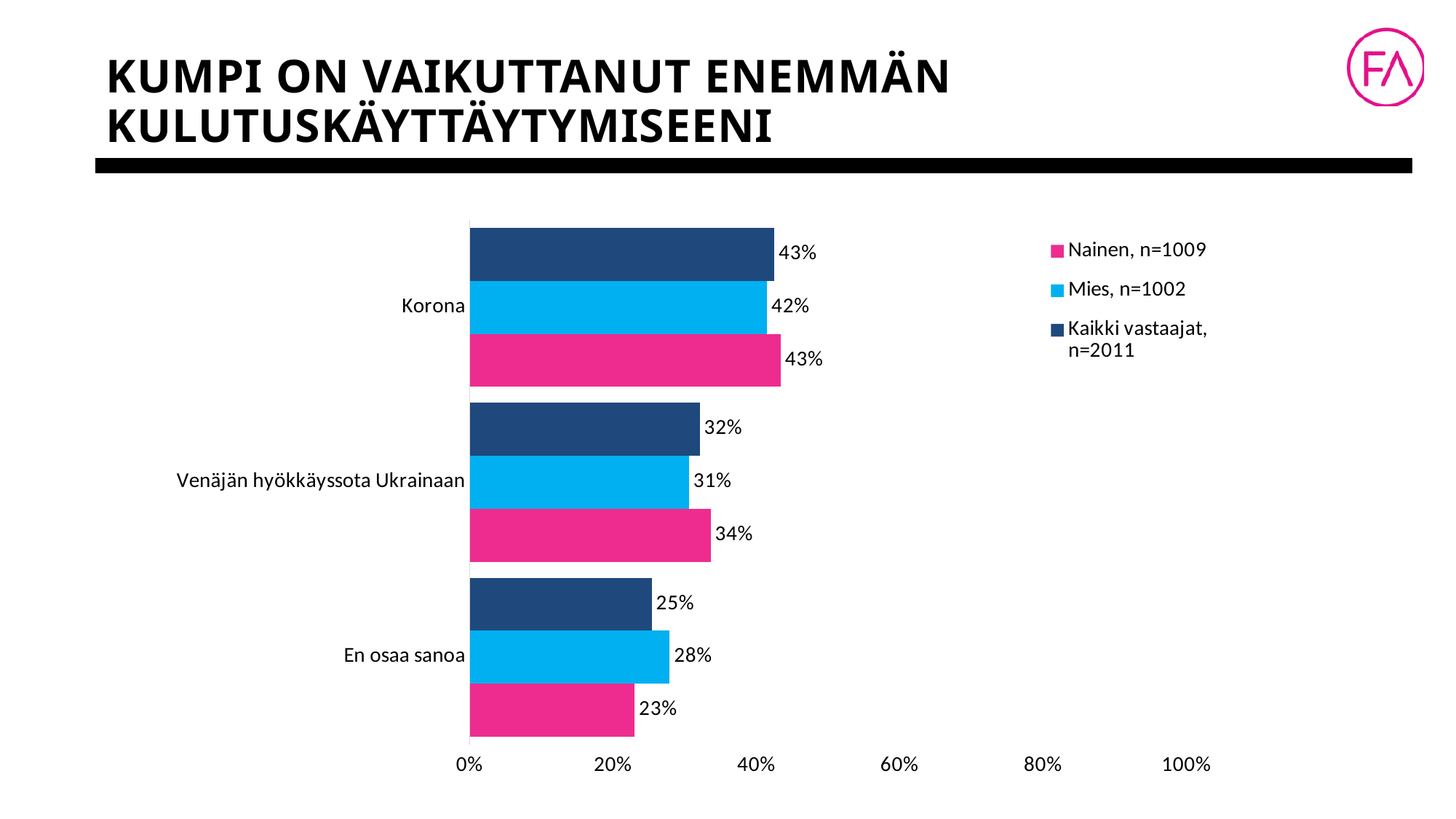
Which category has the lowest value in the Nainen, n=1009 series? En osaa sanoa How many categories are shown on the chart? 3 What is the difference between the Nainen, n=1009 and Mies, n=1002 values for Venäjän hyökkäyssota Ukrainaan? 3% Which colour represents the Mies, n=1002 series? Light blue Is the value for Korona in the Mies, n=1002 series greater or less than 40%? greater What is the value for Korona in the Nainen, n=1009 series? 43% What is the value for En osaa sanoa in the Kaikki vastaajat, n=2011 series? 25% Which category has the highest value in the Kaikki vastaajat, n=2011 series? Korona What is the value for Venäjän hyökkäyssota Ukrainaan in the Mies, n=1002 series? 31% What kind of chart is shown on the slide? Bar chart For En osaa sanoa, which series has the larger value: Mies, n=1002 or Nainen, n=1009? Mies, n=1002 How many series does the legend list? 3